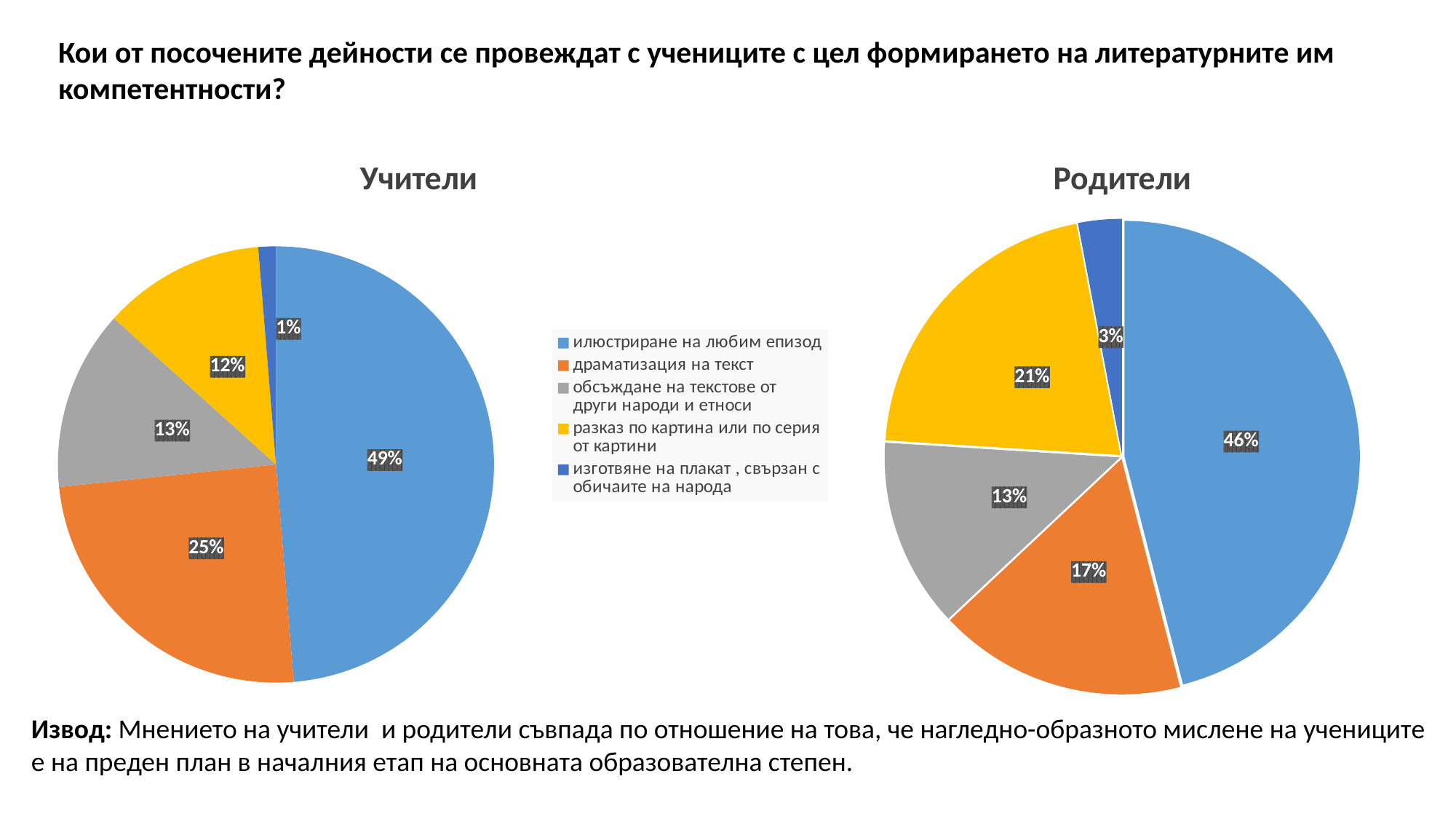
In the "Родители" pie chart, what share is shown for "изготвяне на плакат , свързан с обичаите на народа"? 3% Which colour represents "обсъждане на текстове от други народи и етноси" in the legend? Grey In the "Родители" pie chart, which category has the largest slice? илюстриране на любим епизод In the "Родители" pie chart, what share is shown for "разказ по картина или по серия от картини"? 21% What is the difference between the share for "драматизация на текст" in the "Учители" chart and in the "Родители" chart? 8% What type of chart is used for "Учители"? Pie chart In the "Учители" pie chart, which category has the smallest slice? изготвяне на плакат , свързан с обичаите на народа In the "Учители" pie chart, what share is shown for "драматизация на текст"? 25% Which chart shows a larger share for "разказ по картина или по серия от картини", "Учители" or "Родители"? Родители How many entries does the legend list? 5 How many slices does the "Родители" pie chart have? 5 In the "Учители" pie chart, what share is shown for "илюстриране на любим епизод"? 49%